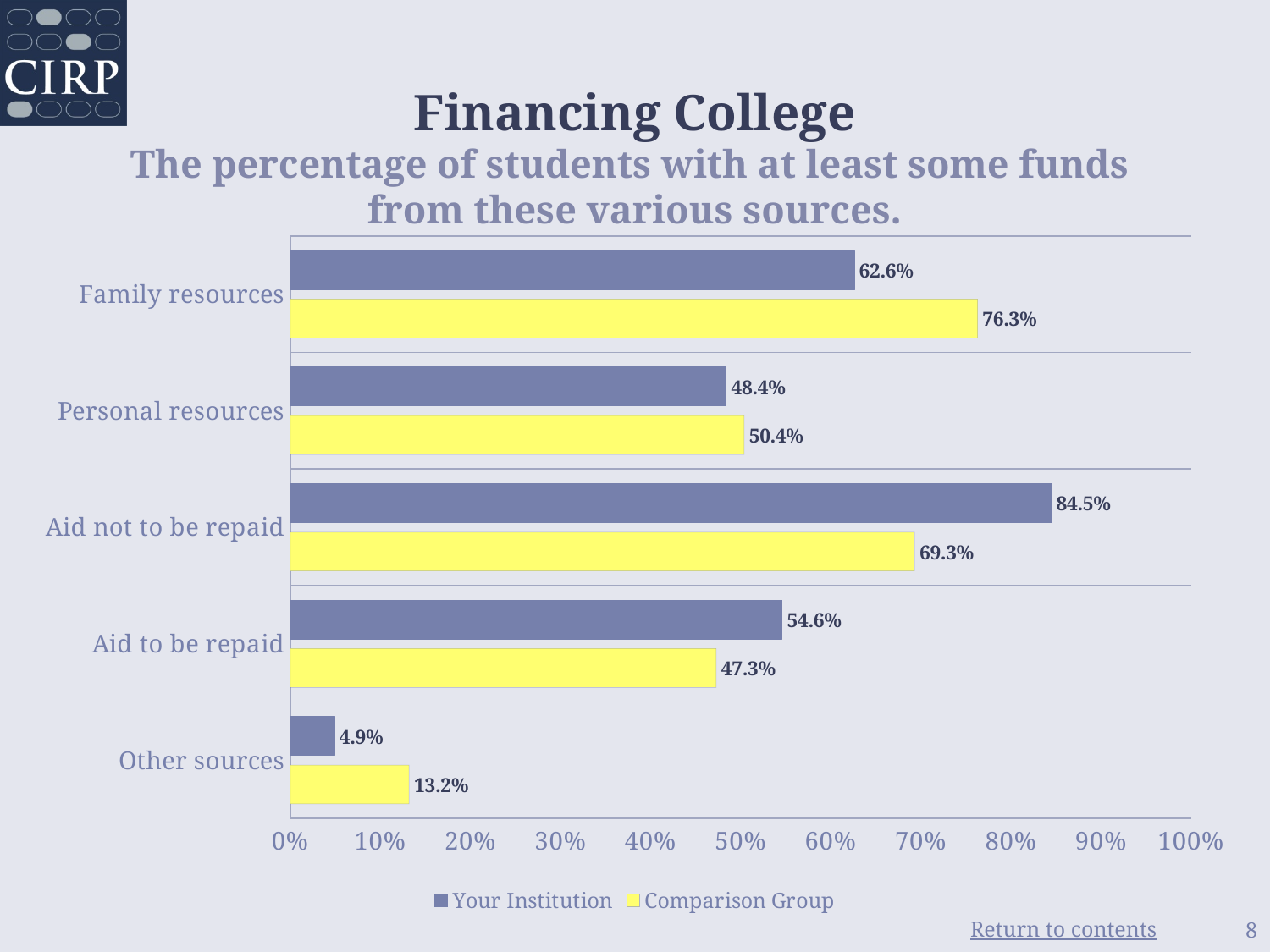
What is the value for Comparison Group for Other sources? 13.2% Which category has the lowest value for Comparison Group? Other sources How many categories are shown on the chart? 5 Which is larger for Aid to be repaid: Your Institution or Comparison Group? Your Institution What is the difference between Your Institution and Comparison Group for Aid not to be repaid? 15.2% What is the value for Your Institution for Family resources? 62.6% Which category has the highest value for Your Institution? Aid not to be repaid How many series does the legend list? 2 What is the value for Comparison Group for Aid not to be repaid? 69.3% What is the difference between Comparison Group and Your Institution for Family resources? 13.7% Is the value for Your Institution for Personal resources greater or less than 50%? less What kind of chart is shown on the slide? bar chart